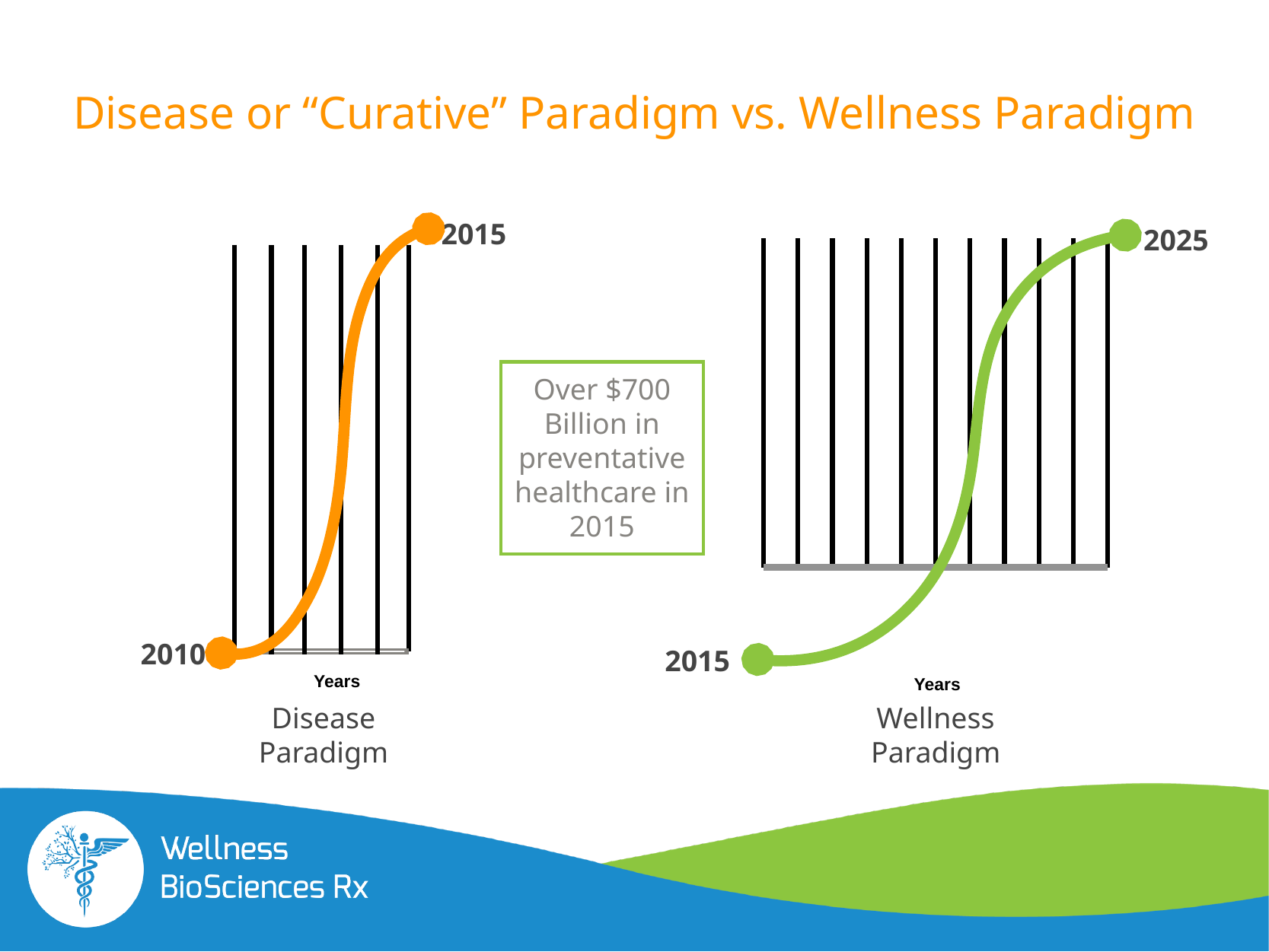
In the Wellness Paradigm chart, does the curve rise or fall from 2015 to 2025? rise In the Wellness Paradigm chart, what year is labelled at the start of the curve? 2015 In the Disease Paradigm chart, does the curve rise or fall from 2010 to 2015? rise What kind of chart is the Wellness Paradigm chart on the right? line chart What is the x-axis label on the Disease Paradigm chart? Years How many labelled year points are marked on the Disease Paradigm curve? 2 In the Wellness Paradigm chart, what year is labelled at the end of the curve? 2025 In the Disease Paradigm chart, what year is labelled at the end of the curve? 2015 What colour is the curve in the Wellness Paradigm chart? green In the Disease Paradigm chart, what year is labelled at the start of the curve? 2010 What kind of chart is the Disease Paradigm chart on the left? line chart How many labelled year points are marked on the Wellness Paradigm curve? 2